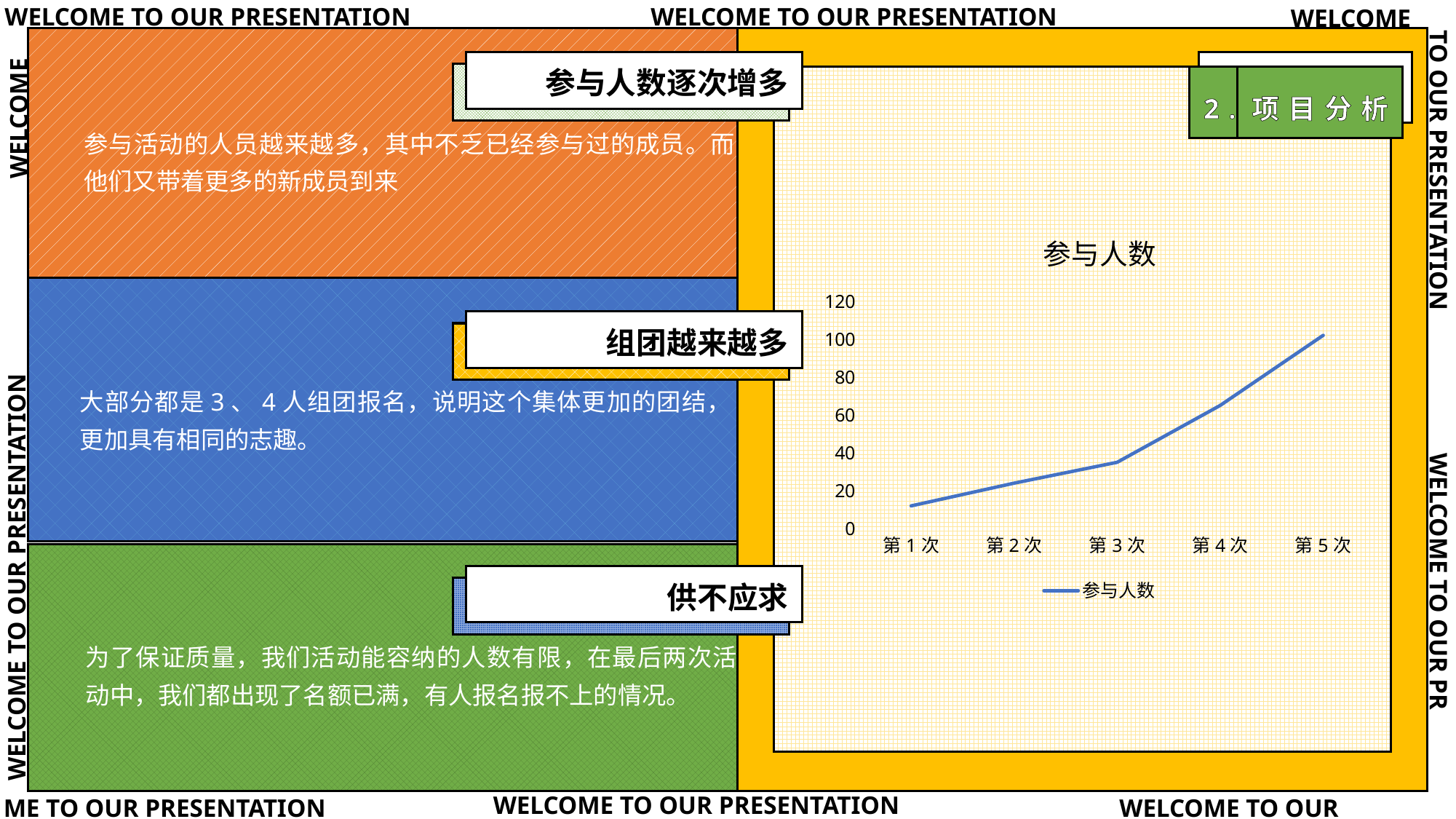
Is the value for 第1次 greater or less than 20? less What kind of chart is shown on the slide? line chart Which is larger, the value for 第4次 or the value for 第2次? 第4次 Is the value for 第5次 greater or less than 80? greater Which category has the highest value in the chart? 第5次 How many series does the chart's legend list? 1 What is the title of the chart? 参与人数 Do the values rise or fall from 第1次 to 第5次? rise Is the value for 第4次 greater or less than 40? greater Which category has the lowest value in the chart? 第1次 How many points are plotted along the x axis of the chart? 5